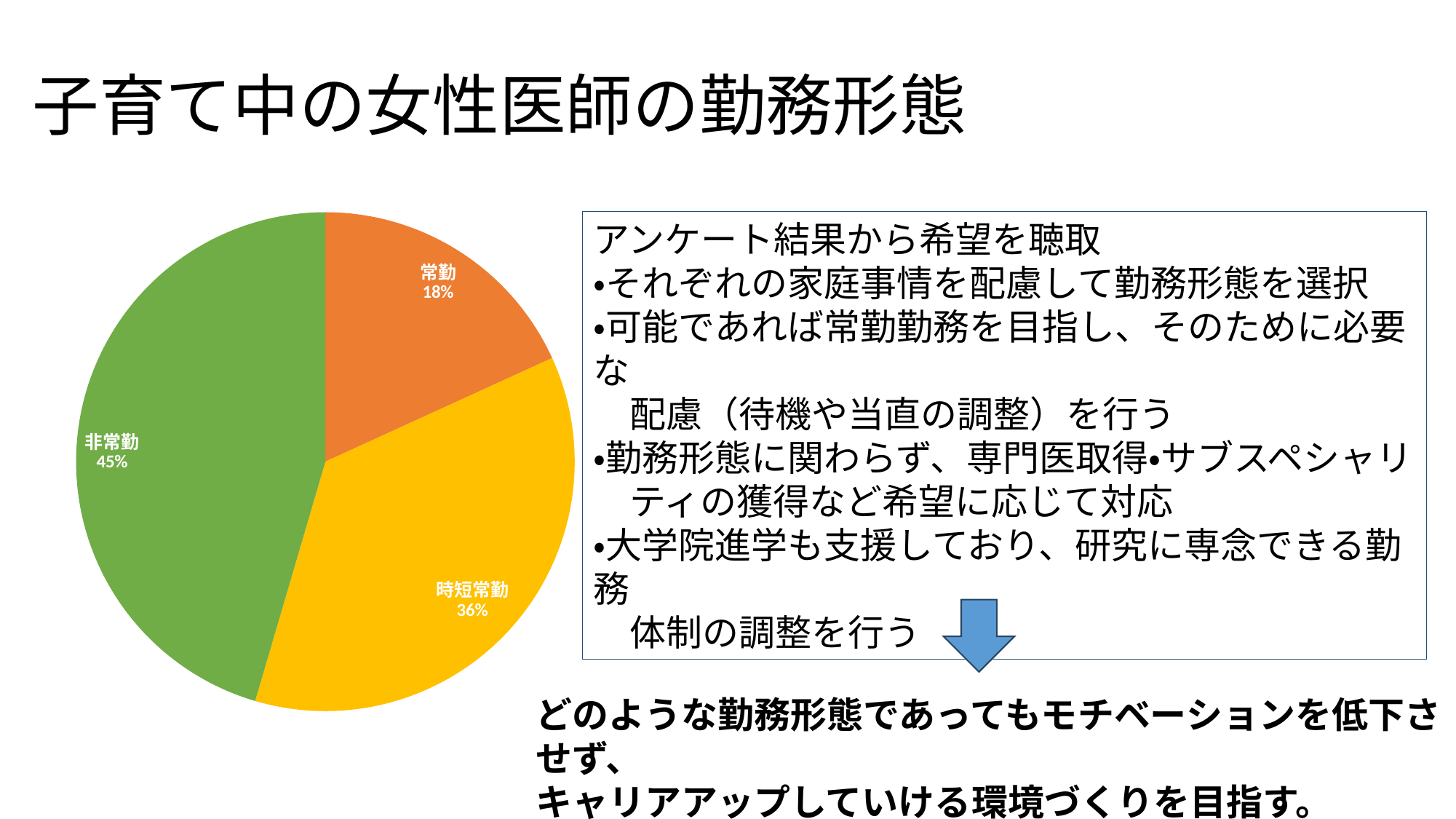
Which is larger, the share for 時短常勤 or the share for 常勤? 時短常勤 Which category has the largest slice in the pie chart? 非常勤 What share of the pie chart does 常勤 represent? 18% Which category has the smallest slice in the pie chart? 常勤 What share of the pie chart does 時短常勤 represent? 36% What colour is the 非常勤 slice in the pie chart? green What share of the pie chart does 非常勤 represent? 45% What kind of chart is shown on the slide? pie chart What is the difference in percentage points between 時短常勤 and 常勤? 18 What colour is the 常勤 slice in the pie chart? orange How many categories are shown in the pie chart? 3 What is the difference in percentage points between 非常勤 and 常勤? 27